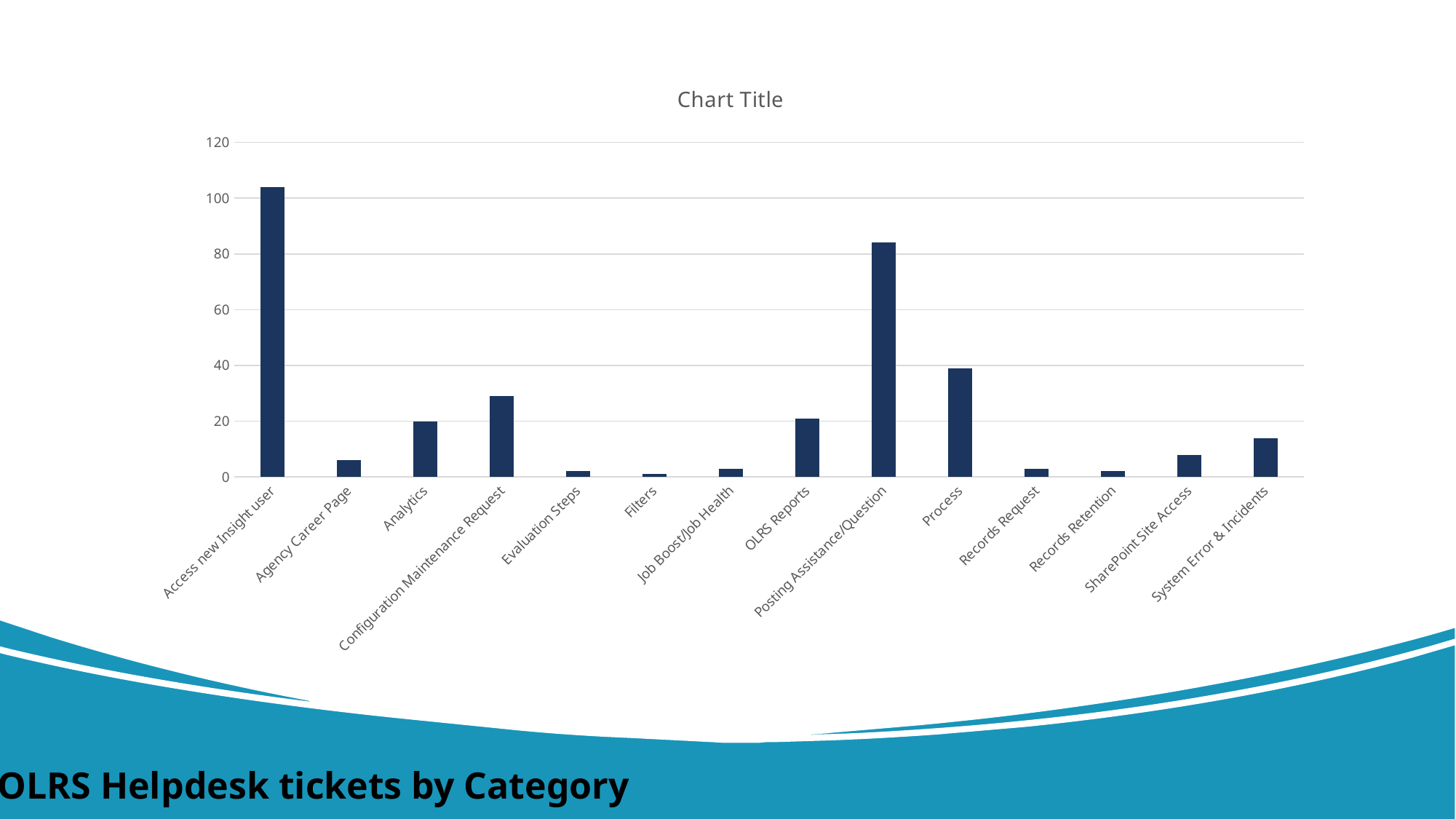
Which is larger, the value for Posting Assistance/Question or the value for Process? Posting Assistance/Question Which is larger, the value for OLRS Reports or the value for Agency Career Page? OLRS Reports Which category has the highest value in the chart? Access new Insight user Is the value for System Error & Incidents greater or less than 20? less What kind of chart is shown on the slide? bar chart Is the value for Access new Insight user greater or less than 100? greater Is the value for Posting Assistance/Question greater or less than 80? greater What is the title printed above the chart? Chart Title How many categories are shown on the x axis of the chart? 14 What is the value for Analytics? 20